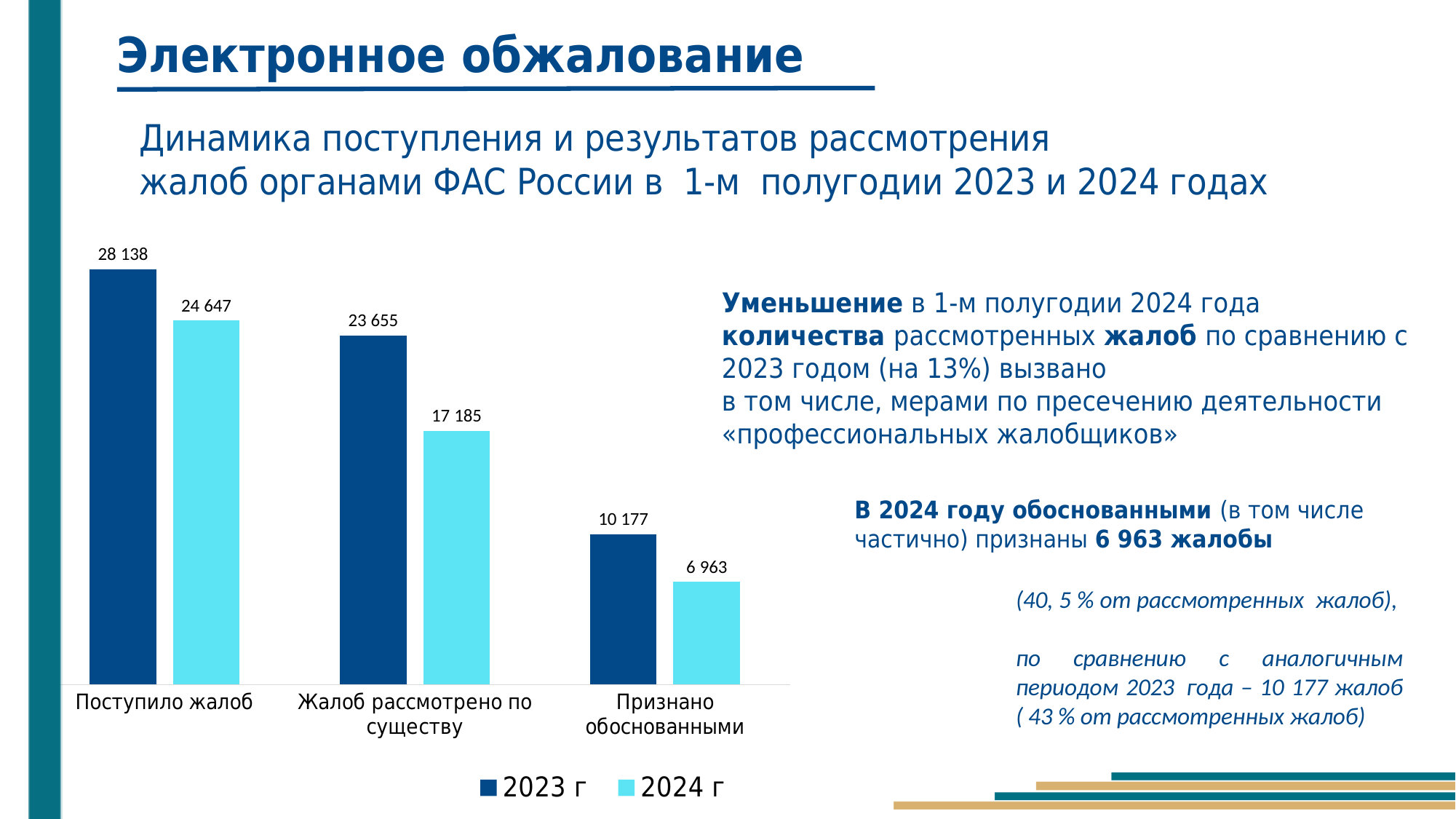
Which category has the lowest value in the 2024 г series? Признано обоснованными What is the value for "Жалоб рассмотрено по существу" in the 2024 г series? 17 185 What is the value for "Поступило жалоб" in the 2024 г series? 24 647 What is the value for "Поступило жалоб" in the 2023 г series? 28 138 Which category has the highest value in the 2023 г series? Поступило жалоб How many series does the chart legend list? 2 How many categories are shown on the x axis of the chart? 3 What type of chart is shown on the slide? Bar chart Which is larger for "Признано обоснованными": the 2023 г value or the 2024 г value? 2023 г What are the two legend entries of the chart? 2023 г and 2024 г What is the value for "Признано обоснованными" in the 2023 г series? 10 177 What is the difference between the 2023 г and 2024 г values for "Жалоб рассмотрено по существу"? 6 470